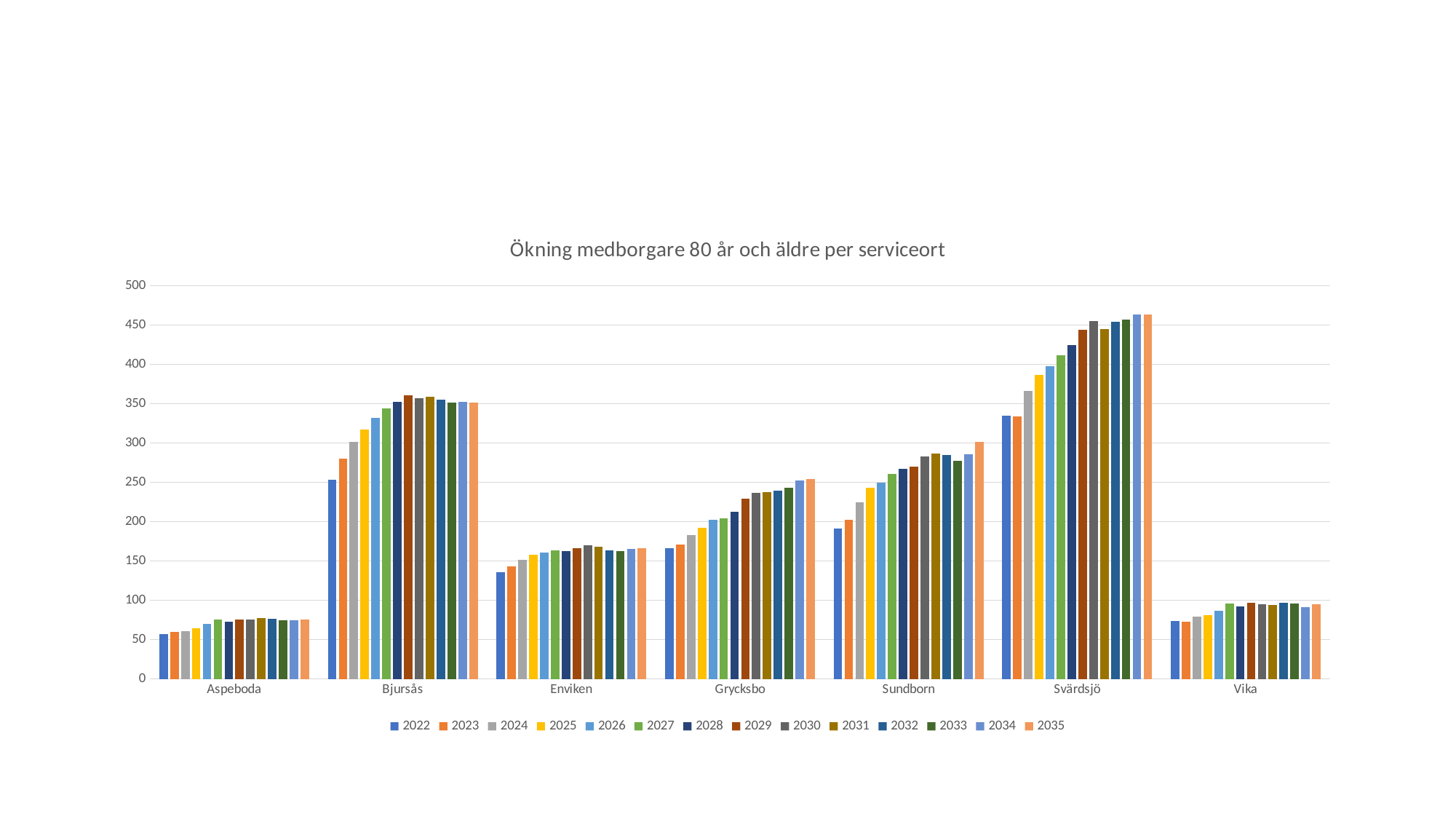
What type of chart is shown on the slide? Bar chart Is the value for Vika in 2022 greater or less than 100? less Is the value for Svärdsjö in 2035 greater or less than 450? greater Is the value for Sundborn in 2035 greater or less than 250? greater How many service locations (categories) are shown on the x axis? 7 Which service location has the lowest values overall? Aspeboda Which is larger in 2035: the value for Bjursås or the value for Grycksbo? Bjursås Do the values for Svärdsjö rise or fall from 2022 to 2035? Rise How many series (years) does the legend list? 14 What is the title of the chart? Ökning medborgare 80 år och äldre per serviceort Which service location has the highest values overall? Svärdsjö